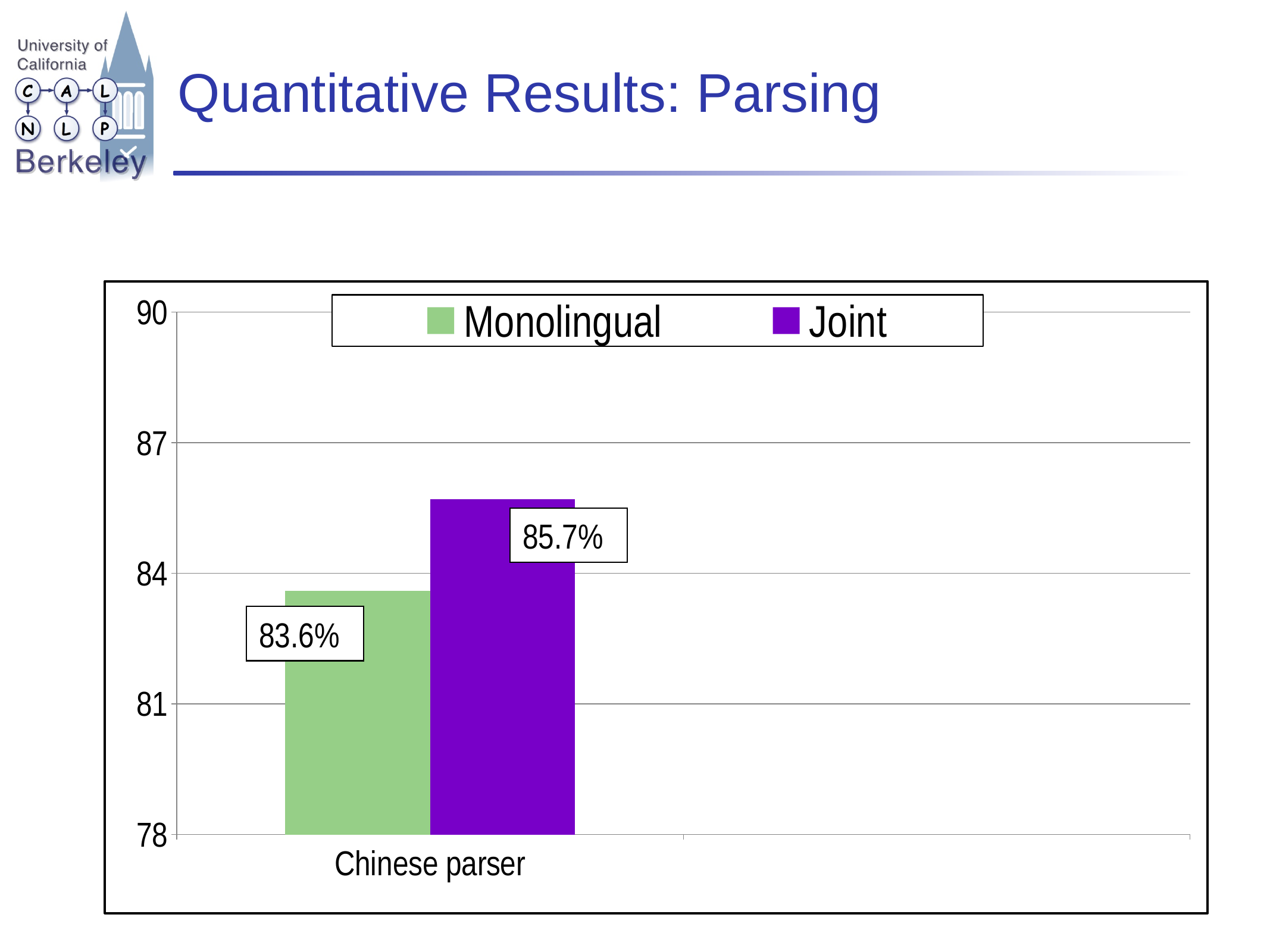
What is the difference between the Joint and Monolingual values for the Chinese parser? 2.1% What is the value for Joint on the Chinese parser? 85.7% Which series has the higher value for the Chinese parser, Monolingual or Joint? Joint How many series does the legend list? 2 What kind of chart is shown on the slide? Bar chart Is the value for Joint greater or less than 84? greater Is the value for Monolingual greater or less than 84? less What colour is the Joint bar? Purple Which series has the lowest value on the chart? Monolingual How many categories are shown on the x axis? 1 What is the category label on the x axis? Chinese parser What is the value for Monolingual on the Chinese parser? 83.6%